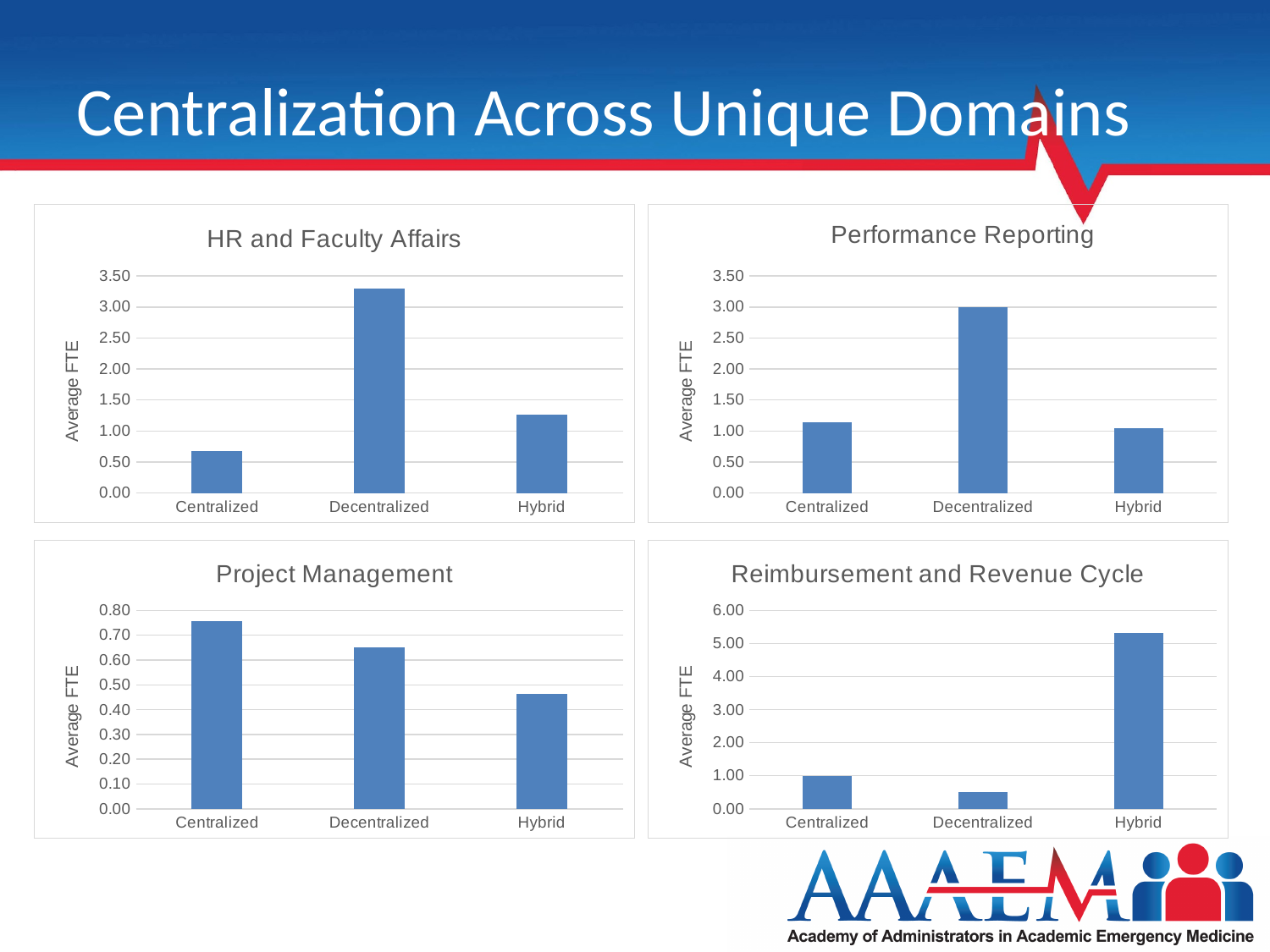
In the Reimbursement and Revenue Cycle chart, is the value for Hybrid greater or less than 5.00? greater In the HR and Faculty Affairs chart, which category has the highest average FTE? Decentralized In the Project Management chart, which category has the lowest average FTE? Hybrid In the Project Management chart, which category has the highest average FTE? Centralized In the HR and Faculty Affairs chart, is the value for Decentralized greater or less than 3.00? greater In the Reimbursement and Revenue Cycle chart, which category has the highest average FTE? Hybrid In the Project Management chart, is the value for Hybrid greater or less than 0.50? less How many categories are shown on the x axis of the Performance Reporting chart? 3 In the HR and Faculty Affairs chart, which category has the lowest average FTE? Centralized In the Reimbursement and Revenue Cycle chart, which is larger, the value for Centralized or the value for Decentralized? Centralized What kind of chart is the Project Management chart? Bar chart